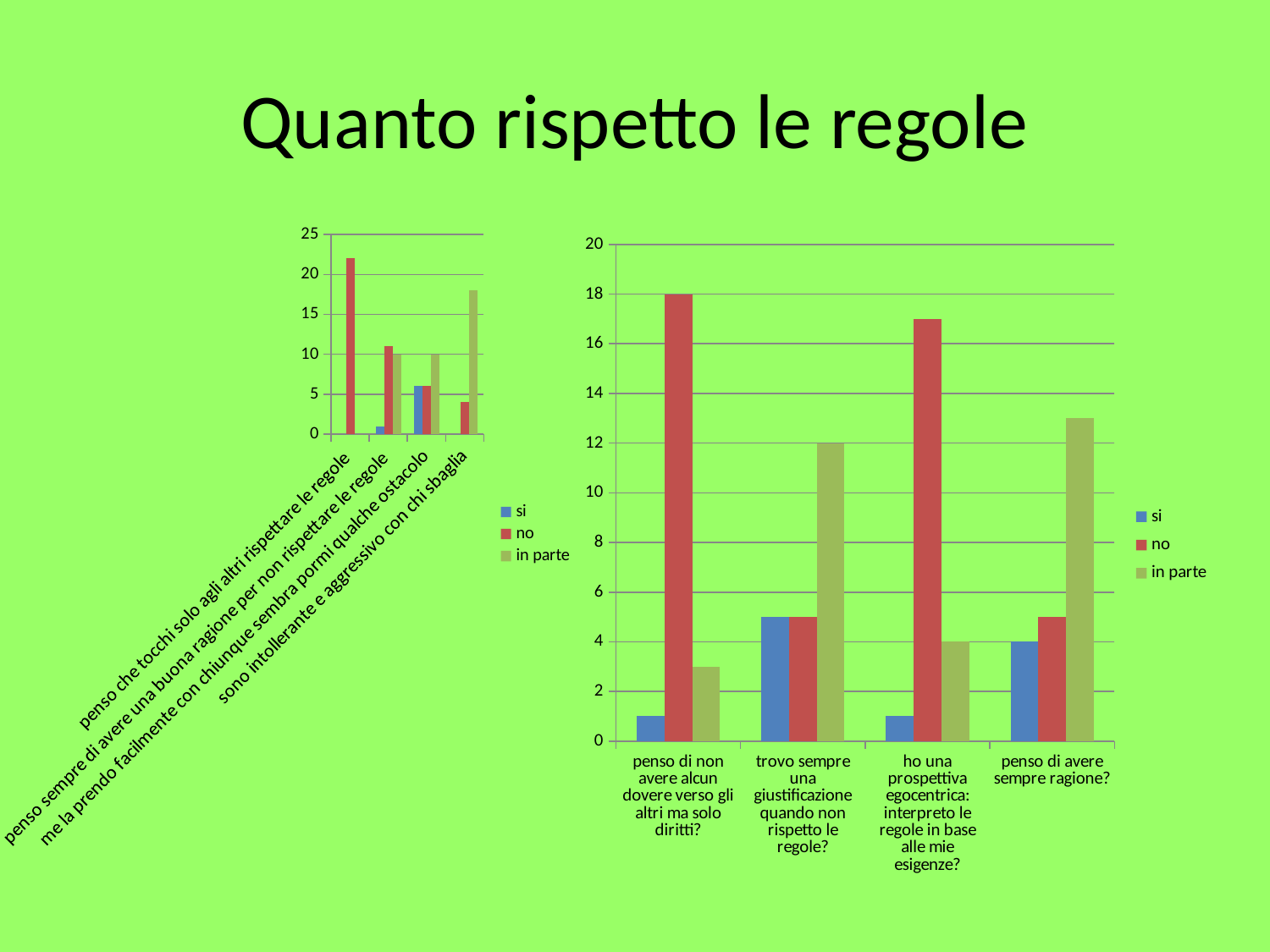
How many categories are shown on the right chart? 4 On the right chart, what is the value of the "no" series for "penso di non avere alcun dovere verso gli altri ma solo diritti?"? 18 On the left chart, is the "no" value for "penso che tocchi solo agli altri rispettare le regole" greater or less than 20? greater On the right chart, what is the value of the "in parte" series for "ho una prospettiva egocentrica: interpreto le regole in base alle mie esigenze?"? 4 On the right chart, for "trovo sempre una giustificazione quando non rispetto le regole?", which is larger: "si" or "in parte"? in parte How many series does the legend of the right chart list? 3 On the right chart, is the "in parte" value for "penso di avere sempre ragione?" greater or less than 12? greater What type of chart is the right chart? bar chart On the right chart, which category has the highest "no" value? penso di non avere alcun dovere verso gli altri ma solo diritti? On the left chart, which category has the highest "in parte" value? sono intollerante e aggressivo con chi sbaglia On the right chart, is the "no" value for "ho una prospettiva egocentrica: interpreto le regole in base alle mie esigenze?" greater or less than 16? greater On the right chart, what is the value of the "in parte" series for "trovo sempre una giustificazione quando non rispetto le regole?"? 12